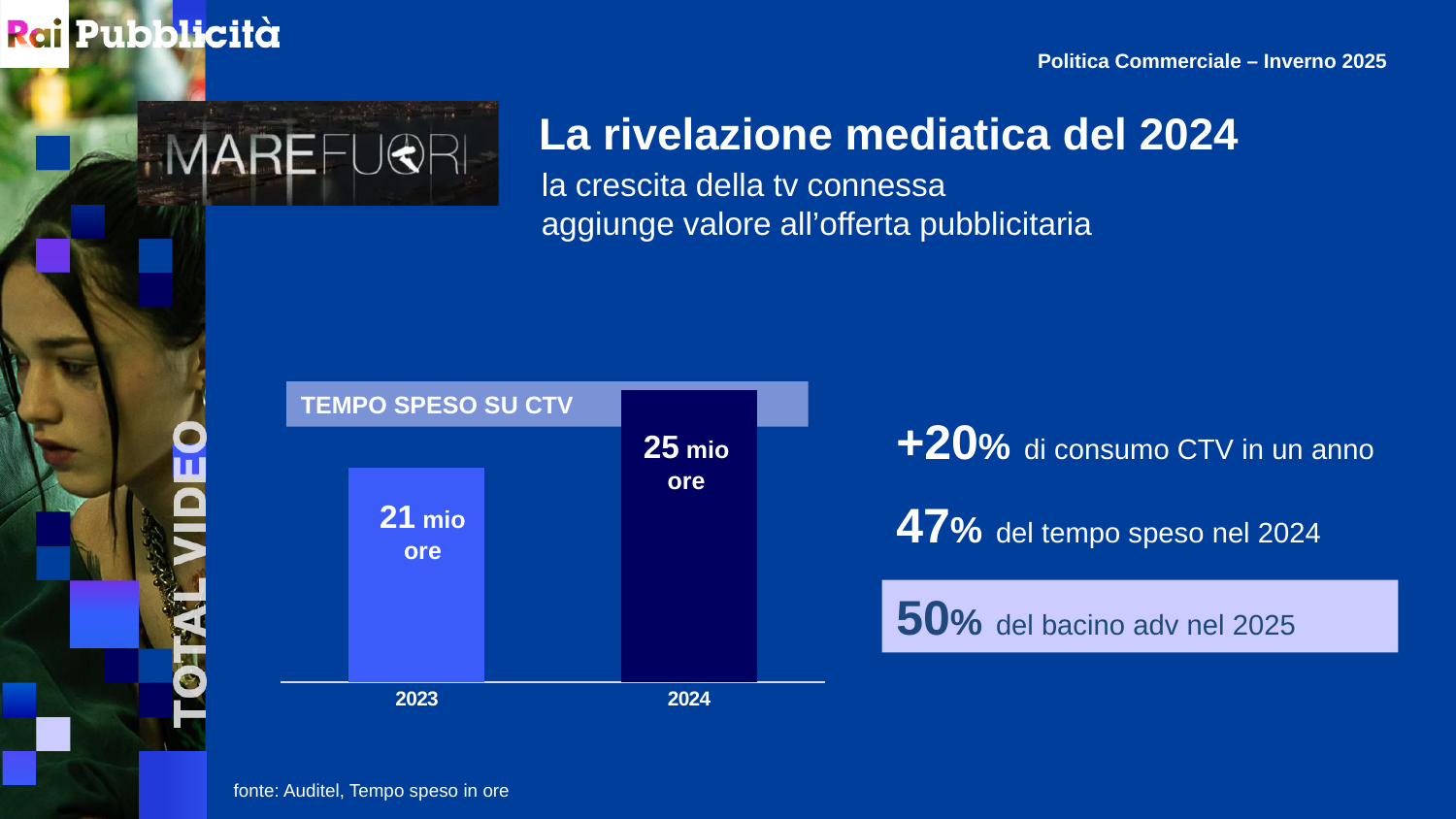
What is the source cited for the chart data? Auditel, Tempo speso in ore What is the value for 2024 in the 'TEMPO SPESO SU CTV' chart? 25 mio ore Is the value for 2024 larger or smaller than the value for 2023 in the 'TEMPO SPESO SU CTV' chart? larger What is the title of the chart on the slide? TEMPO SPESO SU CTV Which year has the higher value in the 'TEMPO SPESO SU CTV' chart? 2024 How many bars are shown in the 'TEMPO SPESO SU CTV' chart? 2 What is the difference in millions of hours between 2024 and 2023 in the 'TEMPO SPESO SU CTV' chart? 4 mio ore Do the values rise or fall from 2023 to 2024 in the 'TEMPO SPESO SU CTV' chart? rise Which year has the lower value in the 'TEMPO SPESO SU CTV' chart? 2023 What kind of chart is 'TEMPO SPESO SU CTV'? bar chart What is the value for 2023 in the 'TEMPO SPESO SU CTV' chart? 21 mio ore